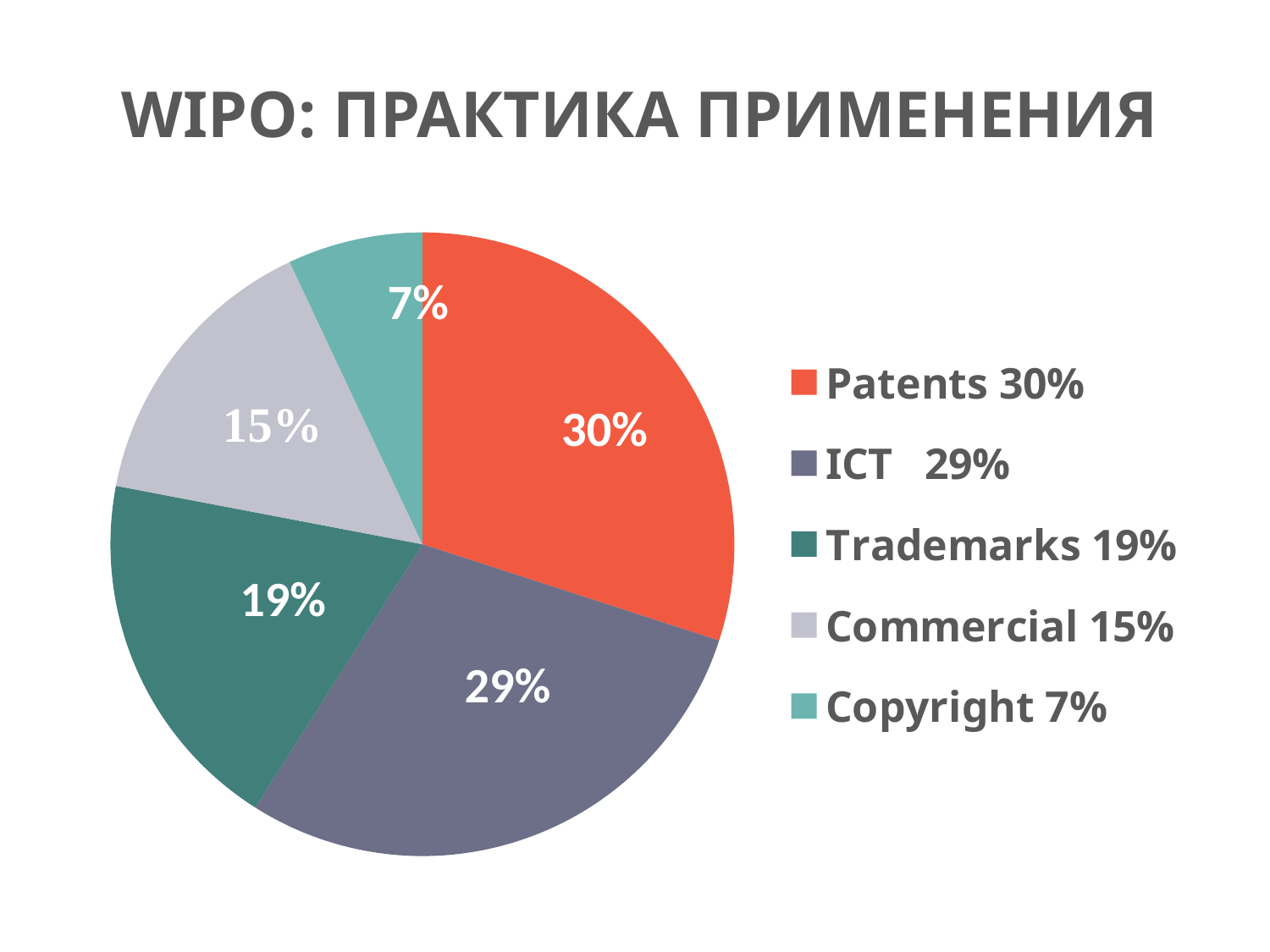
What share of the pie does Commercial have? 15% What share of the pie does Copyright have? 7% Which category has the largest share of the pie? Patents Which has a larger share, Commercial or Trademarks? Trademarks What share of the pie does Trademarks have? 19% How many categories does the pie chart have? 5 What is the title of the slide? WIPO: ПРАКТИКА ПРИМЕНЕНИЯ What is the difference between the shares of Trademarks and Copyright? 12% Which category has the smallest share of the pie? Copyright What kind of chart is shown on the slide? pie chart